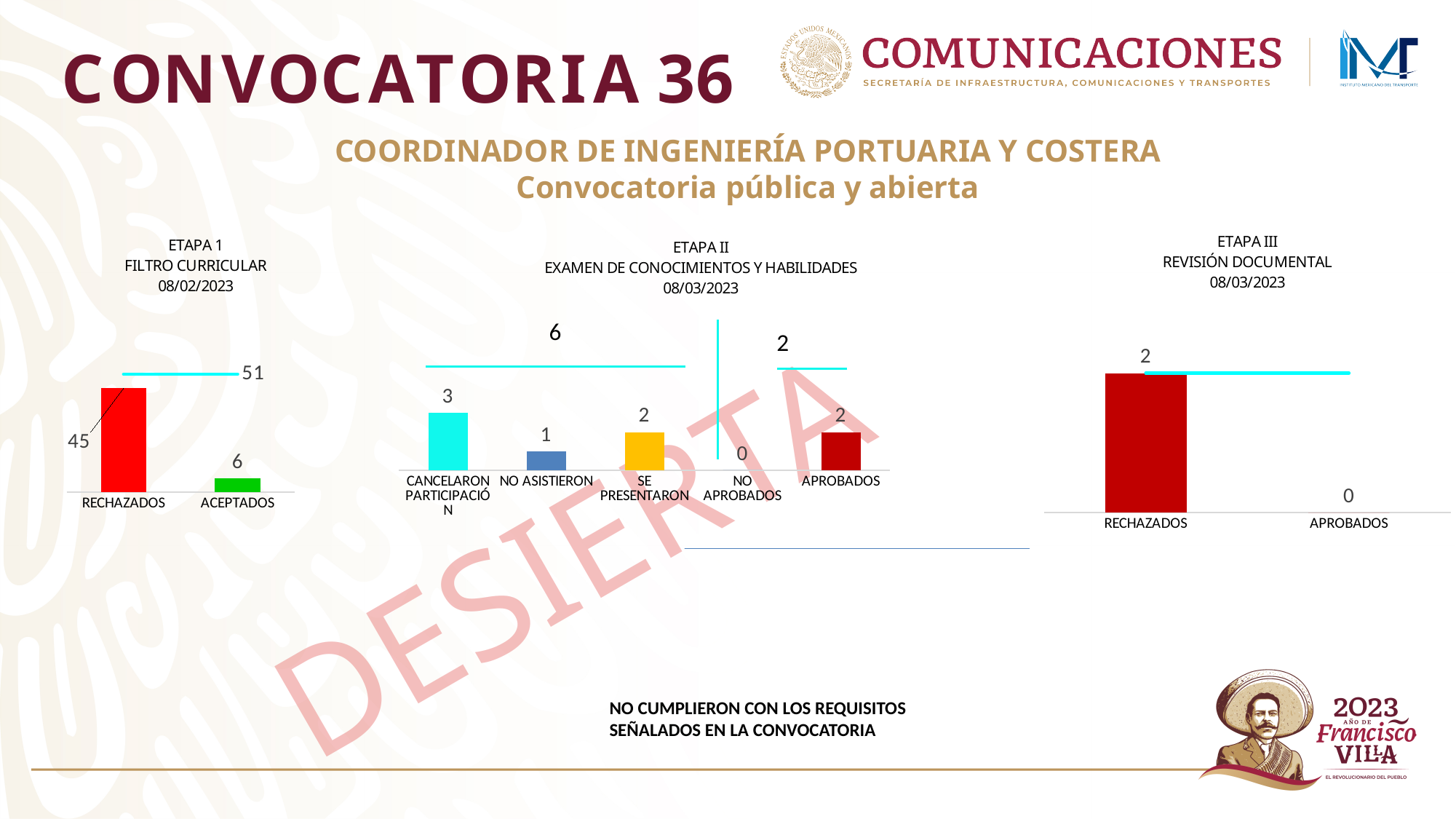
In the ETAPA 1 FILTRO CURRICULAR chart, what total is shown above the bars? 51 In the ETAPA II EXAMEN DE CONOCIMIENTOS Y HABILIDADES chart, what is the value for NO APROBADOS? 0 In the ETAPA 1 FILTRO CURRICULAR chart, what is the value for ACEPTADOS? 6 In the ETAPA II EXAMEN DE CONOCIMIENTOS Y HABILIDADES chart, what is the value for CANCELARON PARTICIPACIÓN? 3 In the ETAPA II EXAMEN DE CONOCIMIENTOS Y HABILIDADES chart, which category has the highest value? CANCELARON PARTICIPACIÓN In the ETAPA II EXAMEN DE CONOCIMIENTOS Y HABILIDADES chart, what is the value for NO ASISTIERON? 1 In the ETAPA 1 FILTRO CURRICULAR chart, what is the value for RECHAZADOS? 45 What kind of chart is the ETAPA 1 FILTRO CURRICULAR chart? Bar chart In the ETAPA III REVISIÓN DOCUMENTAL chart, what is the value for RECHAZADOS? 2 In the ETAPA 1 FILTRO CURRICULAR chart, what is the difference between RECHAZADOS and ACEPTADOS? 39 How many categories are shown in the ETAPA II EXAMEN DE CONOCIMIENTOS Y HABILIDADES chart? 5 In the ETAPA III REVISIÓN DOCUMENTAL chart, which is larger, RECHAZADOS or APROBADOS? RECHAZADOS